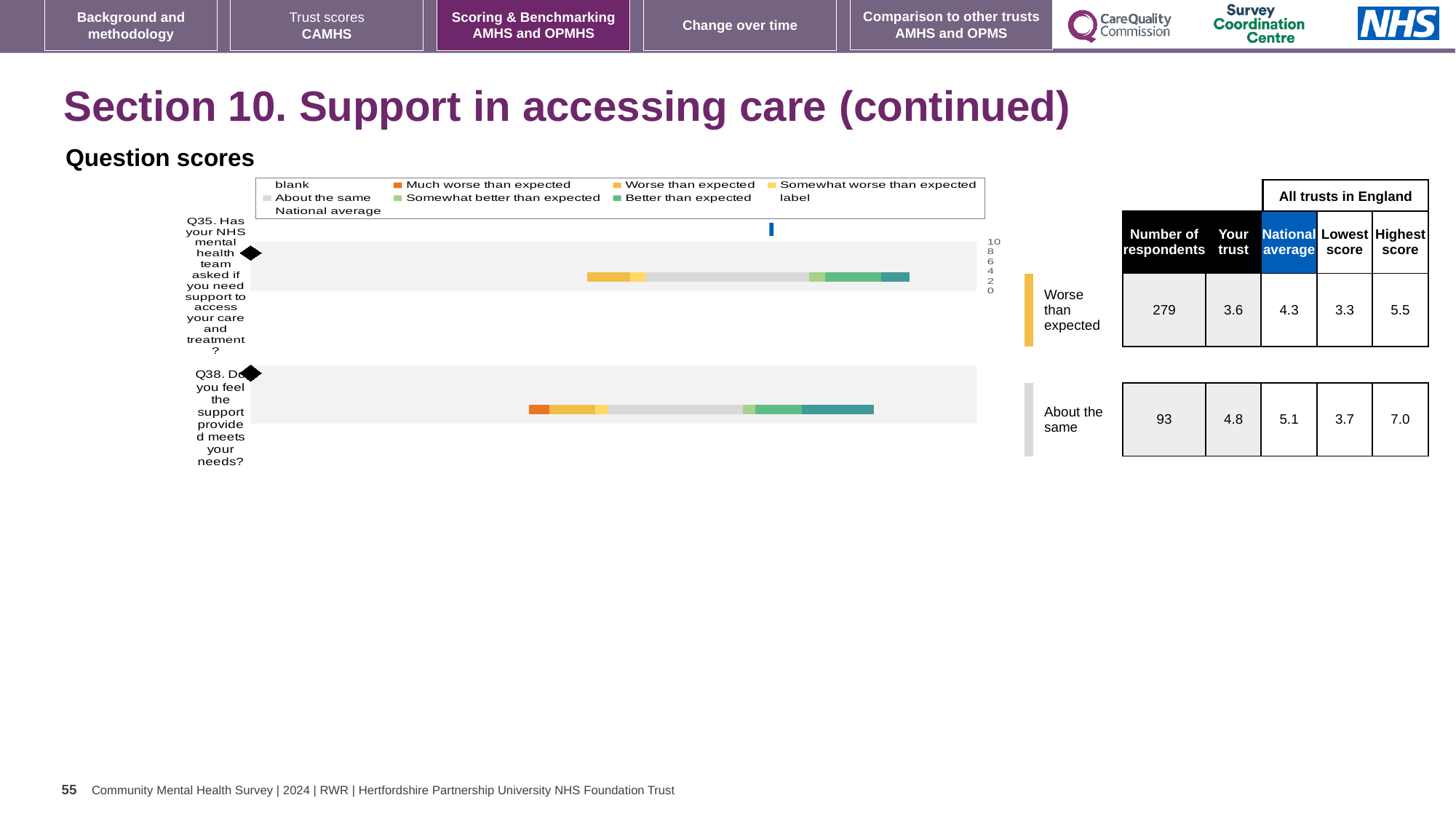
What is the highest score among all trusts in England for Q38? 7.0 What colour is used in the legend for 'Better than expected'? Teal/green What is the national average score for Q38 in the table beside the chart? 5.1 What kind of chart is used to show the question scores on this slide? bar chart Which benchmark category is shown next to the bar for Q38 (Do you feel the support provided meets your needs?)? About the same How many questions are plotted in the question scores chart? 2 What is the difference between the national average and the trust's score for Q35? 0.7 What is the 'Your trust' score for Q35 in the table beside the chart? 3.6 Which benchmark category is shown next to the bar for Q35 (Has your NHS mental health team asked if you need support to access your care and treatment?)? Worse than expected How many respondents answered Q35 according to the table beside the chart? 279 For Q38, is the trust's score or the national average higher? National average Which question had more respondents, Q35 or Q38? Q35